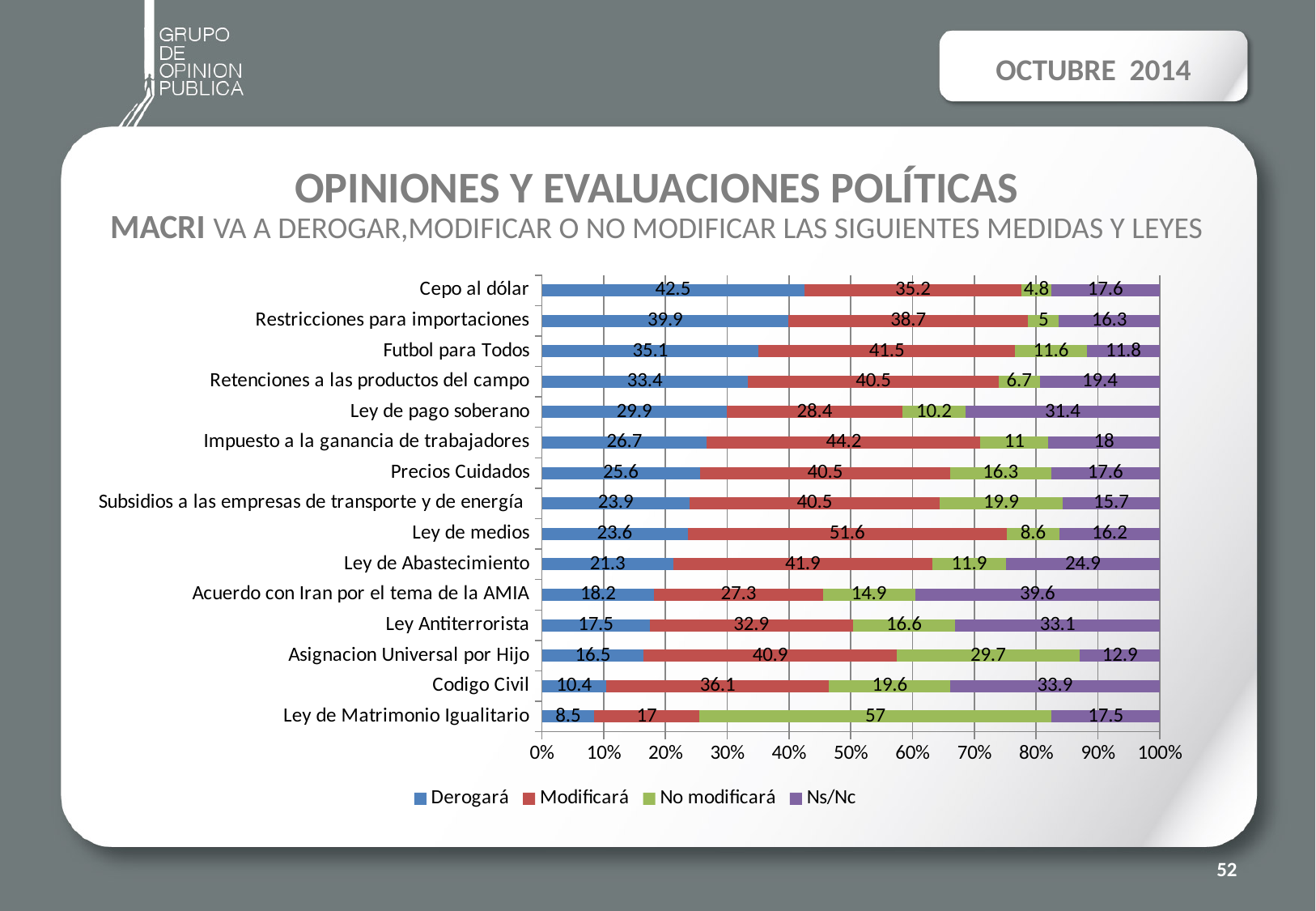
What is the 'Ns/Nc' value for Acuerdo con Iran por el tema de la AMIA? 39.6 How many measures or laws are listed in the chart? 15 Which measure has the lowest 'Derogará' value? Ley de Matrimonio Igualitario How many series does the legend list? 4 What kind of chart is shown on the slide? Stacked bar chart Which measure has the highest 'No modificará' value? Ley de Matrimonio Igualitario Which has a larger 'Ns/Nc' value: Ley de pago soberano or Codigo Civil? Codigo Civil What is the 'Modificará' value for Ley de medios? 51.6 What percentage of respondents said Macri will 'Derogará' (repeal) the Cepo al dólar? 42.5 What is the 'No modificará' value for Ley de Matrimonio Igualitario? 57 What is the difference between the 'Modificará' value for Ley de medios and the 'Modificará' value for Cepo al dólar? 16.4 Which measure has the highest 'Derogará' value? Cepo al dólar